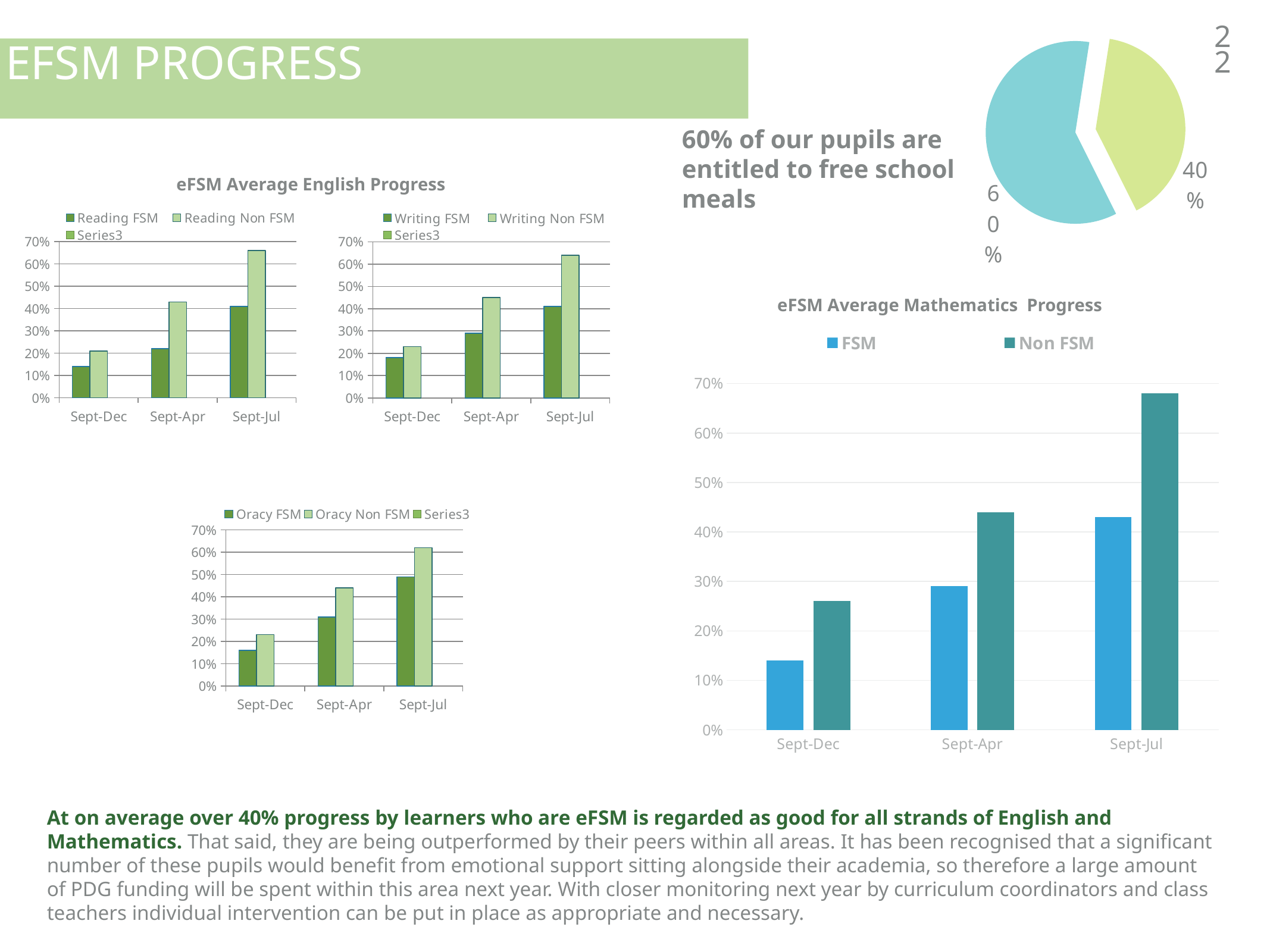
In the eFSM Average Mathematics Progress chart, how many series does the legend list? 2 In the Reading chart under eFSM Average English Progress, is the Reading Non FSM value for Sept-Jul greater or less than 60%? greater In the pie chart at the top right, what is the value of the smaller slice? 40% In the eFSM Average Mathematics Progress chart, which period has the highest Non FSM value? Sept-Jul In the eFSM Average Mathematics Progress chart, do the FSM values rise or fall from Sept-Dec to Sept-Jul? rise In the Oracy chart at the bottom left, is the Oracy FSM value for Sept-Jul greater or less than 40%? greater What kind of chart is the eFSM Average Mathematics Progress chart? bar chart In the eFSM Average Mathematics Progress chart, is the FSM value for Sept-Dec greater or less than 20%? less In the Reading chart under eFSM Average English Progress, how many periods are shown on the x axis? 3 In the pie chart at the top right, what percentage of pupils are entitled to free school meals? 60% In the Writing chart under eFSM Average English Progress, which is larger for Sept-Apr, Writing FSM or Writing Non FSM? Writing Non FSM